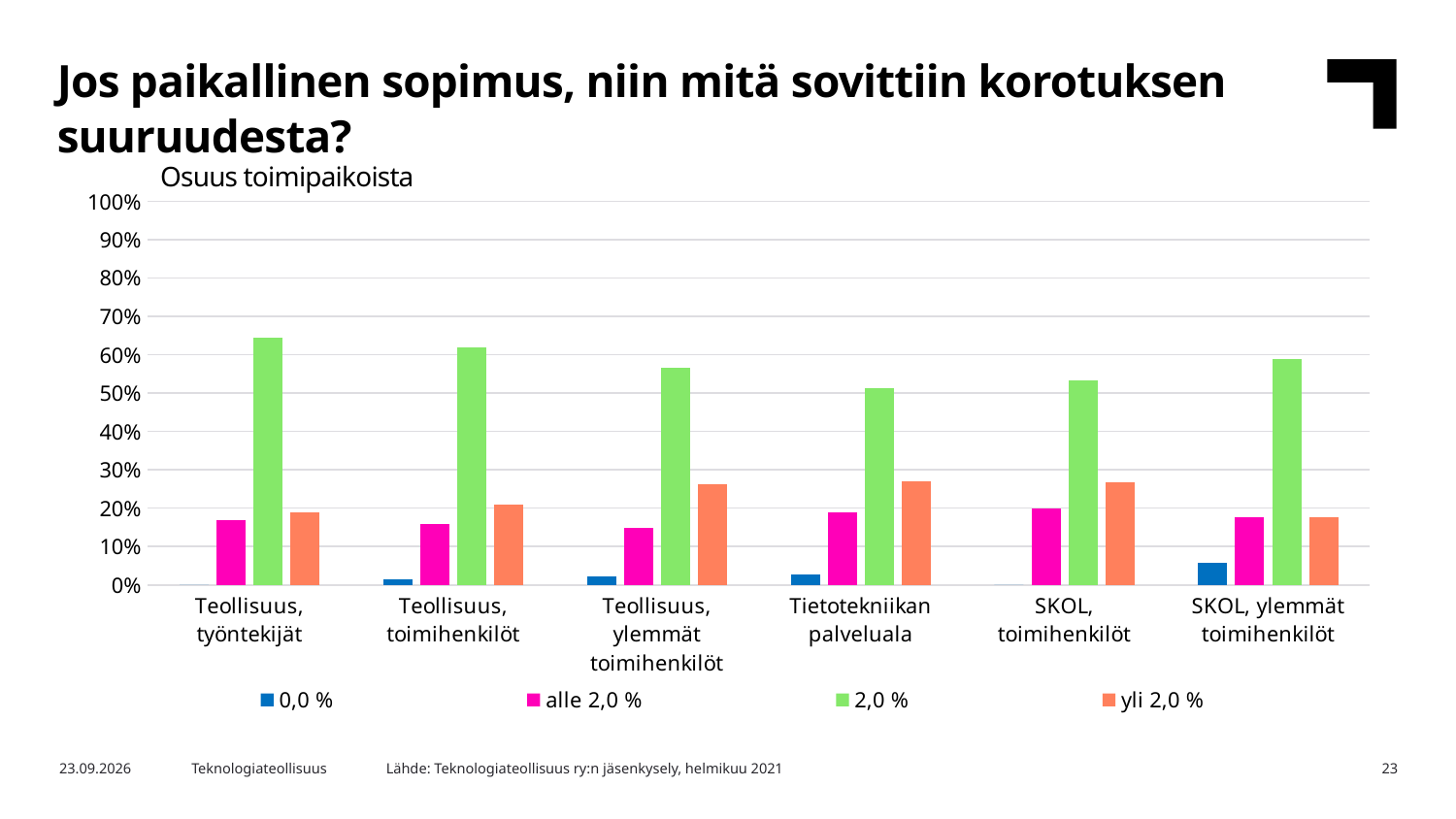
Is the value of the "alle 2,0 %" series for Teollisuus, työntekijät greater or less than 20%? less What is the label shown above the vertical axis of the chart? Osuus toimipaikoista Is the value of the "0,0 %" series for SKOL, ylemmät toimihenkilöt greater or less than 10%? less How many series does the chart's legend list? 4 Which category has the highest value in the "0,0 %" series? SKOL, ylemmät toimihenkilöt Is the value of the "2,0 %" series for Tietotekniikan palveluala greater or less than 50%? greater For Tietotekniikan palveluala, which is larger: the "alle 2,0 %" series or the "yli 2,0 %" series? yli 2,0 % For Teollisuus, työntekijät, which is larger: the "2,0 %" series or the "yli 2,0 %" series? 2,0 % What kind of chart is shown on the slide? bar chart How many categories are shown on the x axis of the chart? 6